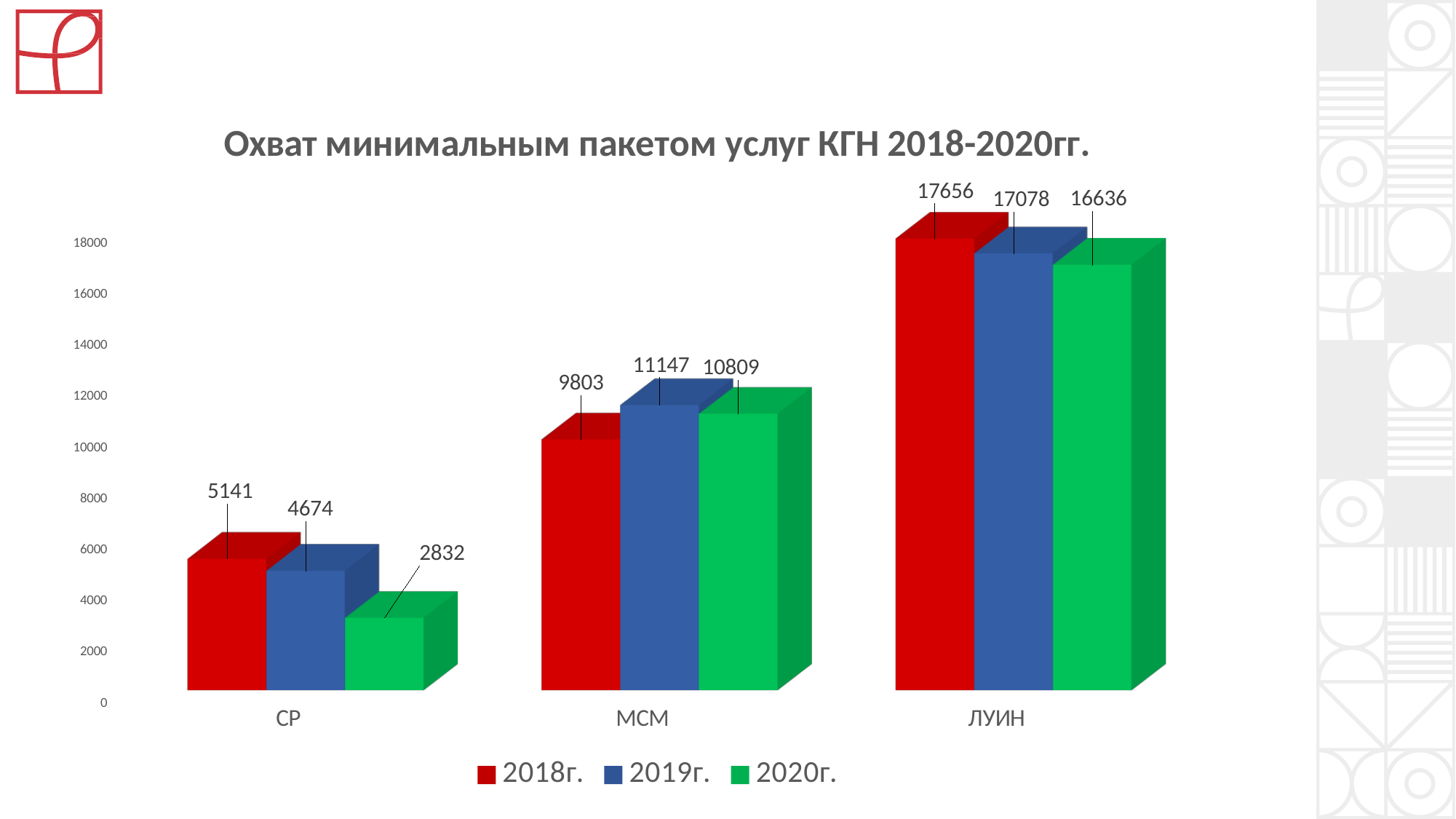
Which is larger for МСМ: the 2018г. value or the 2019г. value? 2019г. What is the difference between the 2019г. and 2020г. values for МСМ? 338 Which category has the highest value in 2019г.? ЛУИН What is the difference between the 2018г. and 2019г. values for СР? 467 What is the title of the chart? Охват минимальным пакетом услуг КГН 2018-2020гг. Which category has the lowest value in 2020г.? СР How many categories are shown on the x axis? 3 How many series does the legend list? 3 What is the value for МСМ in 2019г.? 11147 What is the value for СР in 2020г.? 2832 What is the value for ЛУИН in 2018г.? 17656 What kind of chart is shown on the slide? bar chart